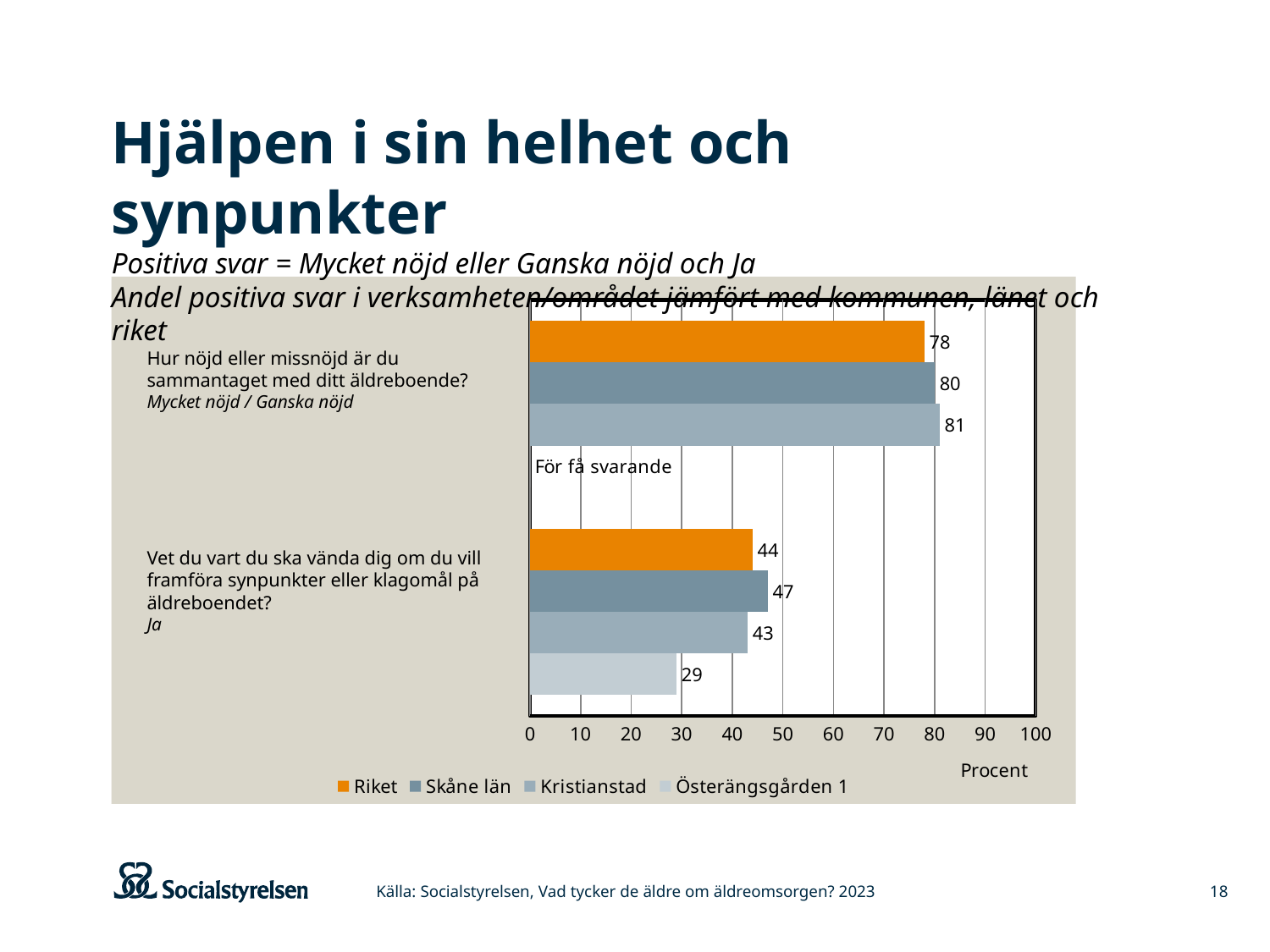
What is the difference between the Skåne län and Riket values on the question "Hur nöjd eller missnöjd är du sammantaget med ditt äldreboende?"? 2 What is the label of the x axis? Procent What is the value for Skåne län on the question "Vet du vart du ska vända dig om du vill framföra synpunkter eller klagomål på äldreboendet?"? 47 What kind of chart is shown on the slide? bar chart How many series does the legend list? 4 What is the difference between the Riket and Österängsgården 1 values on the question "Vet du vart du ska vända dig om du vill framföra synpunkter eller klagomål på äldreboendet?"? 15 What is the value for Riket on the question "Hur nöjd eller missnöjd är du sammantaget med ditt äldreboende?"? 78 What is the value for Kristianstad on the question "Hur nöjd eller missnöjd är du sammantaget med ditt äldreboende?"? 81 Which series has the lowest value on the question "Vet du vart du ska vända dig om du vill framföra synpunkter eller klagomål på äldreboendet?"? Österängsgården 1 What is the value for Österängsgården 1 on the question "Vet du vart du ska vända dig om du vill framföra synpunkter eller klagomål på äldreboendet?"? 29 What is shown for Österängsgården 1 on the question "Hur nöjd eller missnöjd är du sammantaget med ditt äldreboende?" instead of a bar? För få svarande Which series has the highest value on the question "Vet du vart du ska vända dig om du vill framföra synpunkter eller klagomål på äldreboendet?"? Skåne län